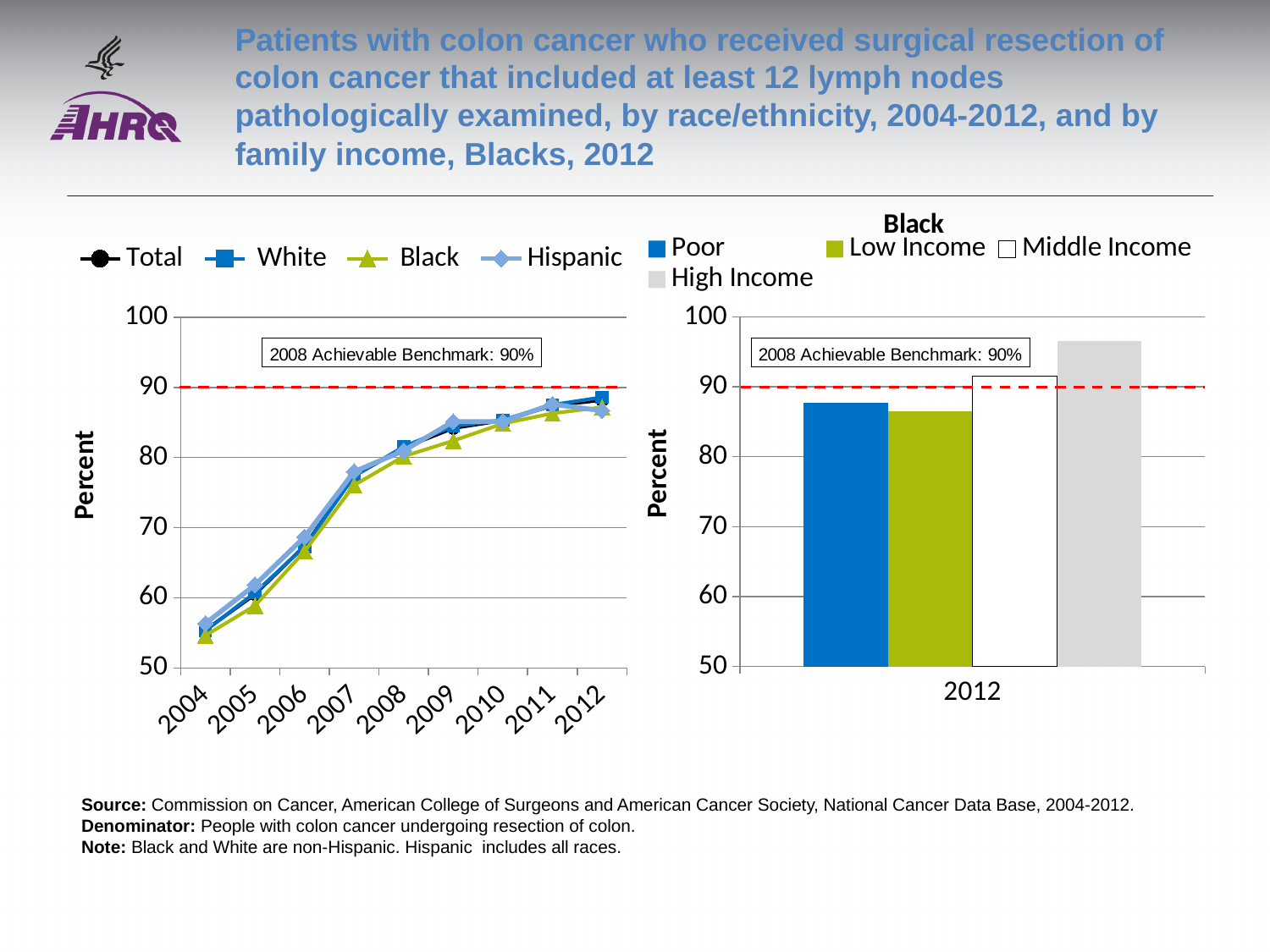
On the right chart (Black, by family income), which income group has the highest value? High Income On the right chart (Black, by family income), is the value for Poor greater or less than 90? less On the left chart, is the value for Black in 2012 greater or less than 90? less On the left chart, what kind of chart is it? line chart On the left chart, is the value for Total in 2004 greater or less than 60? less On the left chart, how many years are shown on the x axis? 9 What achievable benchmark value is shown on the charts? 90% On the left chart, do the values for Total rise or fall from 2004 to 2012? rise On the right chart (Black, by family income), how many income groups are shown? 4 On the left chart, how many series does the legend list? 4 On the left chart, in which year is the Total value lowest? 2004 On the right chart (Black, by family income), what kind of chart is it? bar chart